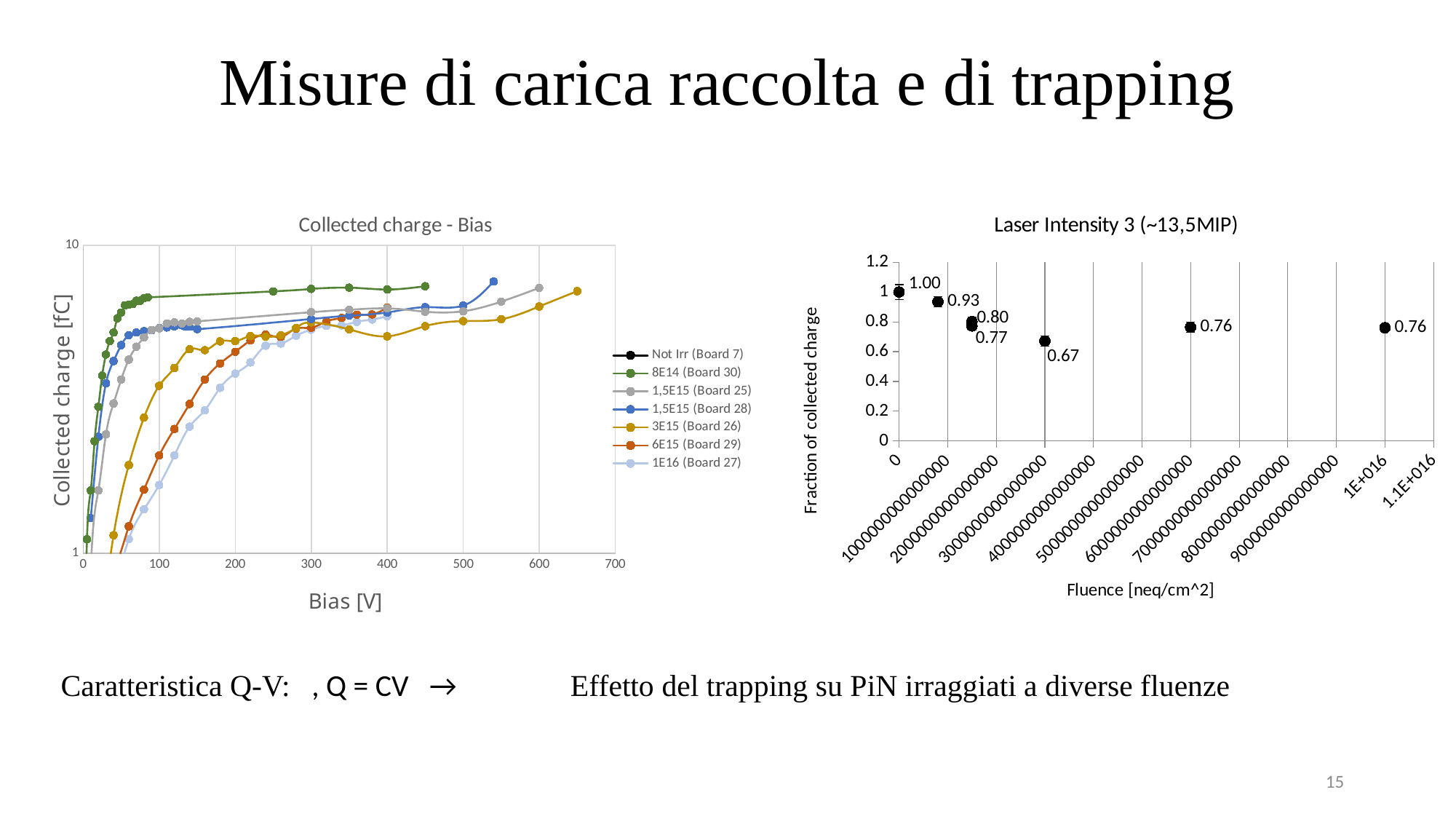
In the 'Laser Intensity 3 (~13,5MIP)' chart, what is the fraction of collected charge at fluence 0? 1.00 In the 'Laser Intensity 3 (~13,5MIP)' chart, what is the lowest labelled fraction of collected charge? 0.67 In the 'Laser Intensity 3 (~13,5MIP)' chart, is the value at fluence 1E+016 greater or less than 0.8? less In the 'Laser Intensity 3 (~13,5MIP)' chart, what is the fraction of collected charge at fluence 1E+016? 0.76 In the 'Laser Intensity 3 (~13,5MIP)' chart, how many data points are plotted? 7 In the 'Collected charge - Bias' chart, how many series does the legend list? 7 In the 'Laser Intensity 3 (~13,5MIP)' chart, what is the difference between the highest labelled value (1.00) and the lowest labelled value (0.67)? 0.33 In the 'Laser Intensity 3 (~13,5MIP)' chart, which is larger: the value at fluence 0 or the value at fluence 1E+016? fluence 0 In the 'Collected charge - Bias' chart, does the collected charge for 1E16 (Board 27) rise or fall as bias increases? rise In the 'Laser Intensity 3 (~13,5MIP)' chart, what is the title of the y axis? Fraction of collected charge In the 'Laser Intensity 3 (~13,5MIP)' chart, what is the highest labelled fraction of collected charge? 1.00 What kind of chart is the 'Collected charge - Bias' chart? line chart